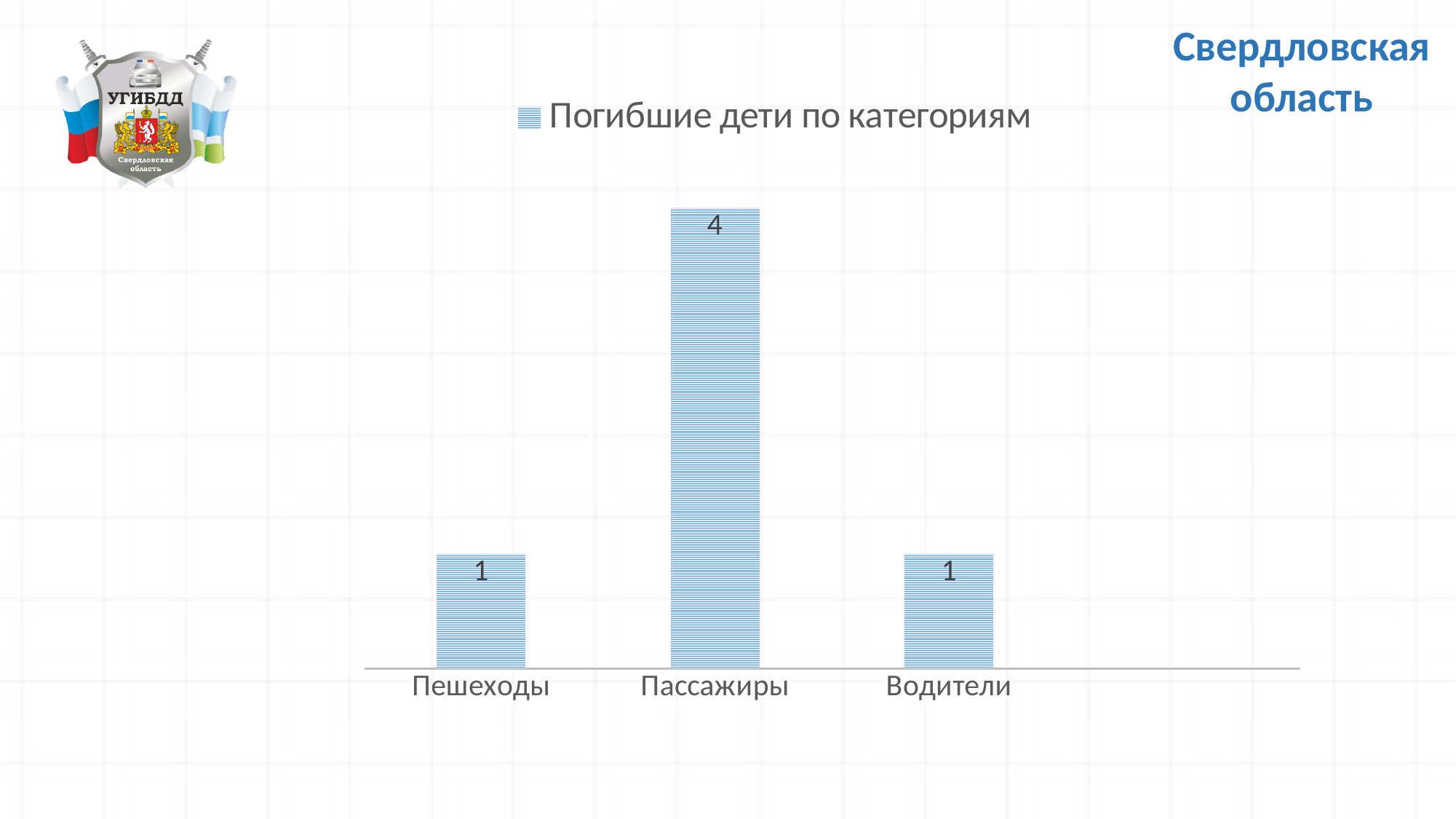
What is the value for Пешеходы? 1 What is the value for Водители? 1 What is the total of all three bars? 6 What kind of chart is shown on the slide? bar chart What is the value for Пассажиры? 4 What is the difference between the values for Пассажиры and Пешеходы? 3 How many series does the legend list? 1 Which category has the highest value? Пассажиры Do the values for Пешеходы and Водители have the same value? Yes What is the legend entry for the series shown? Погибшие дети по категориям How many categories are shown on the x axis? 3 Which is larger, the value for Пассажиры or the value for Водители? Пассажиры